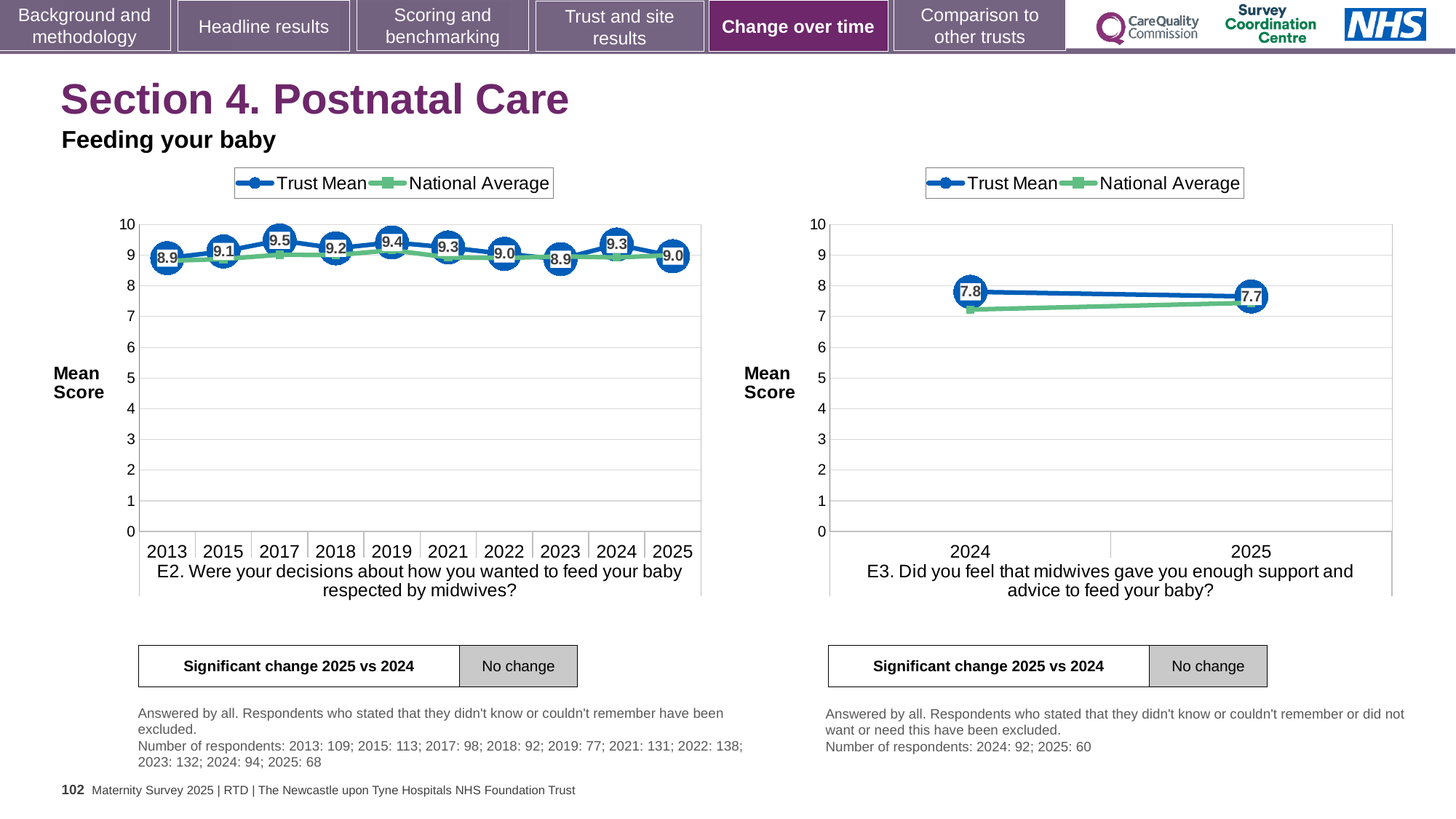
What kind of chart is the left chart (E2)? Line chart On the left chart (E2), what is the Trust Mean for 2017? 9.5 How many years are plotted on the left chart (E2)? 10 On the left chart (E2), what is the Trust Mean for 2025? 9.0 On the left chart (E2), which is larger, the Trust Mean for 2019 or for 2022? 2019 How many series does the legend of the right chart (E3) list? 2 On the right chart (E3), does the Trust Mean rise or fall from 2024 to 2025? Fall On the right chart (E3), what is the difference between the Trust Mean in 2024 and in 2025? 0.1 On the right chart (E3), is the National Average for 2024 greater or less than 8? less On the left chart (E2), what is the difference between the Trust Mean in 2017 and in 2013? 0.6 On the left chart (E2), which year has the highest Trust Mean? 2017 On the right chart (E3), what is the Trust Mean for 2024? 7.8